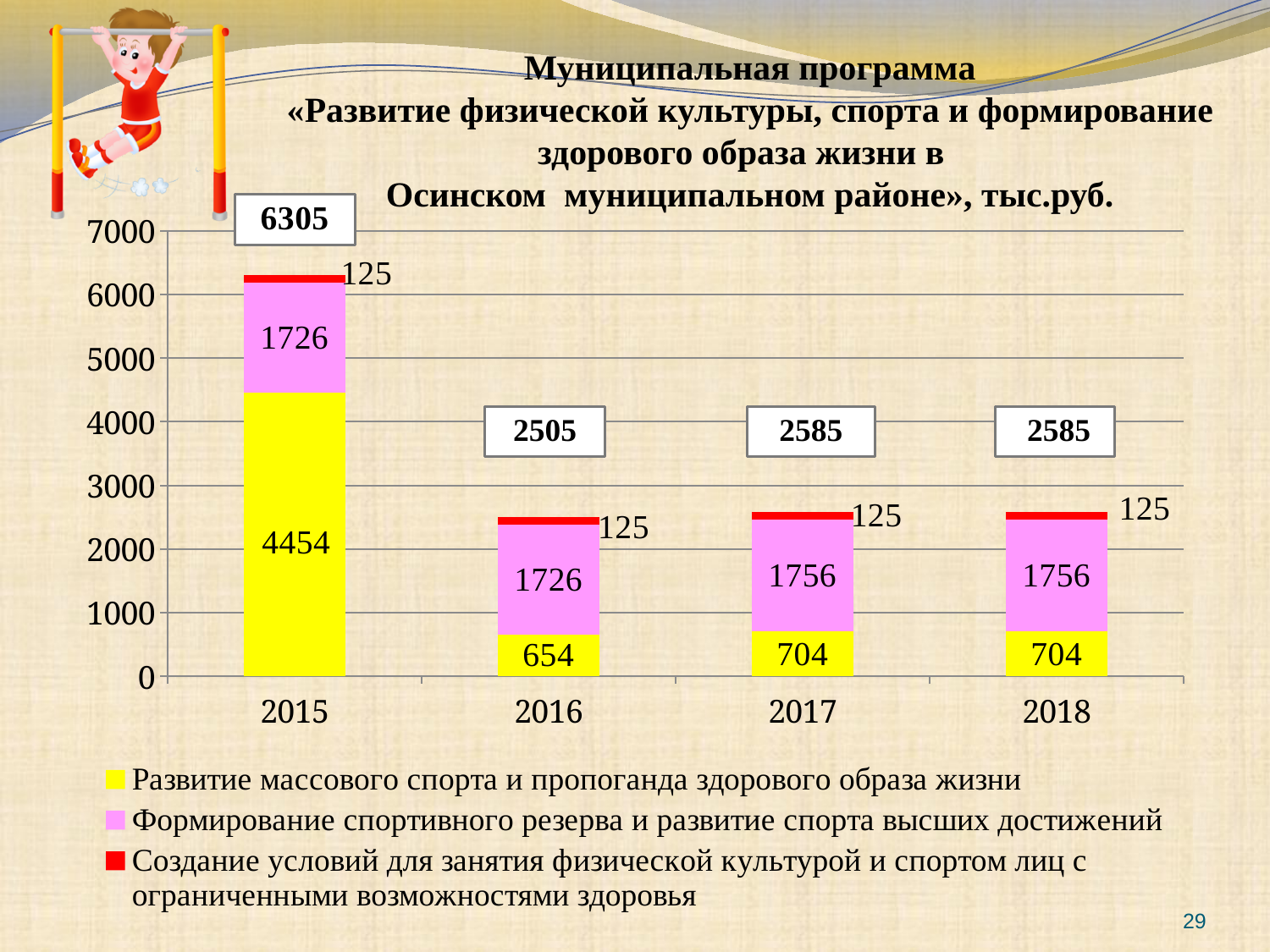
What unit is stated in the chart title? тыс.руб. What is the total of the stacked bar for 2016? 2505 How many series does the legend list? 3 Which is larger: the yellow segment for 2016 or the yellow segment for 2017? 2017 How many years (categories) are shown on the x axis? 4 Which year has the lowest total? 2016 What type of chart is shown on the slide? stacked bar chart What is the difference between the total for 2015 and the total for 2018? 3720 What is the value of the yellow segment (Развитие массового спорта и пропоганда здорового образа жизни) for 2015? 4454 What is the value of the pink segment (Формирование спортивного резерва и развитие спорта высших достижений) for 2017? 1756 What is the value of the red segment (Создание условий для занятия физической культурой и спортом лиц с ограниченными возможностями здоровья) for 2016? 125 Which year has the highest total? 2015